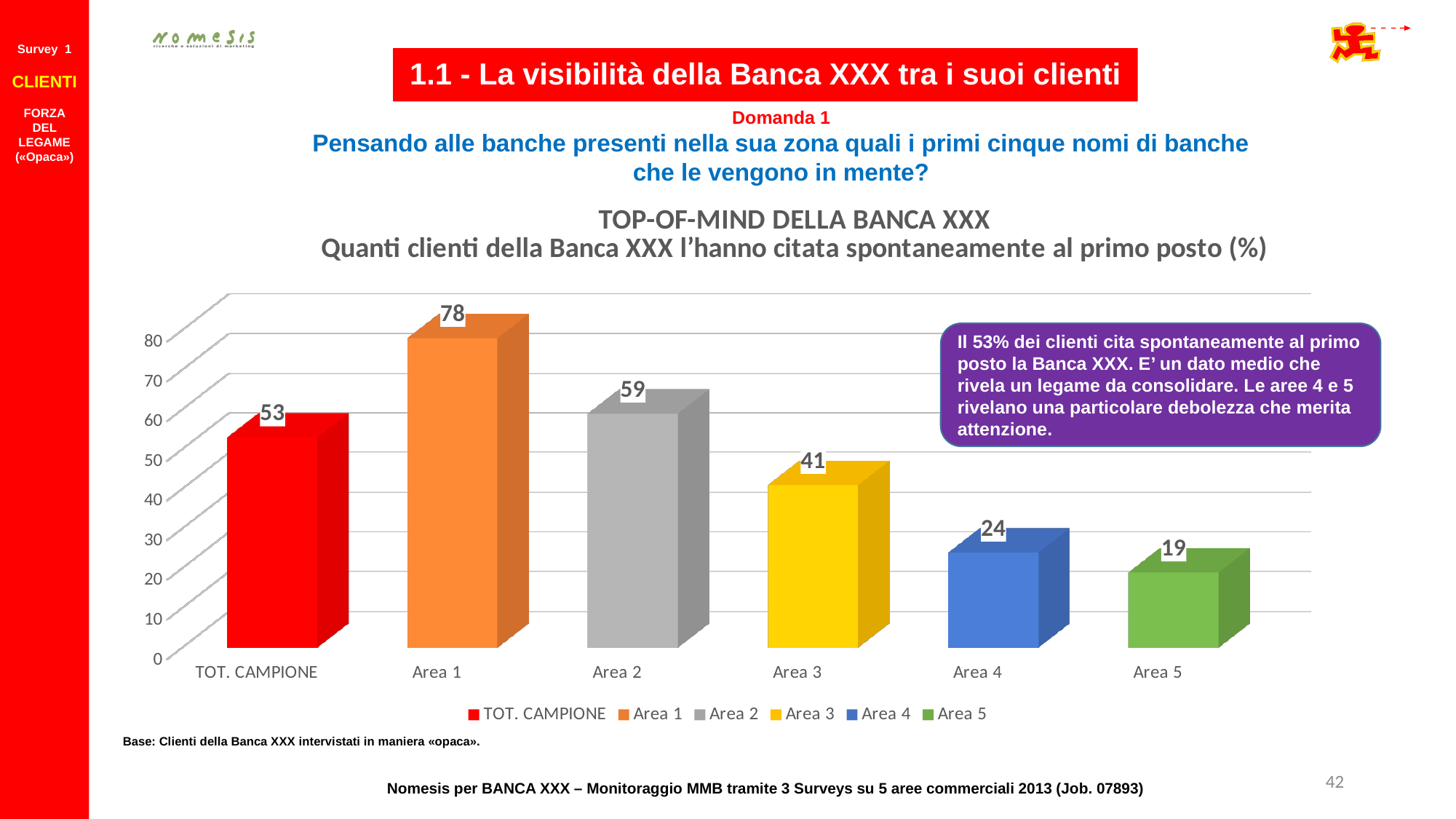
What is the difference between the values for TOT. CAMPIONE and Area 3? 12 Which is larger, the value for Area 2 or the value for Area 3? Area 2 What is the value for Area 4? 24 Which category has the lowest value? Area 5 What is the difference between the values for Area 1 and Area 2? 19 What is the value for TOT. CAMPIONE? 53 How many categories are shown on the x axis? 6 What is the value for Area 1? 78 Which category has the highest value? Area 1 Is the value for Area 5 greater or less than 20? less How many entries does the legend list? 6 What kind of chart is shown on the slide? bar chart